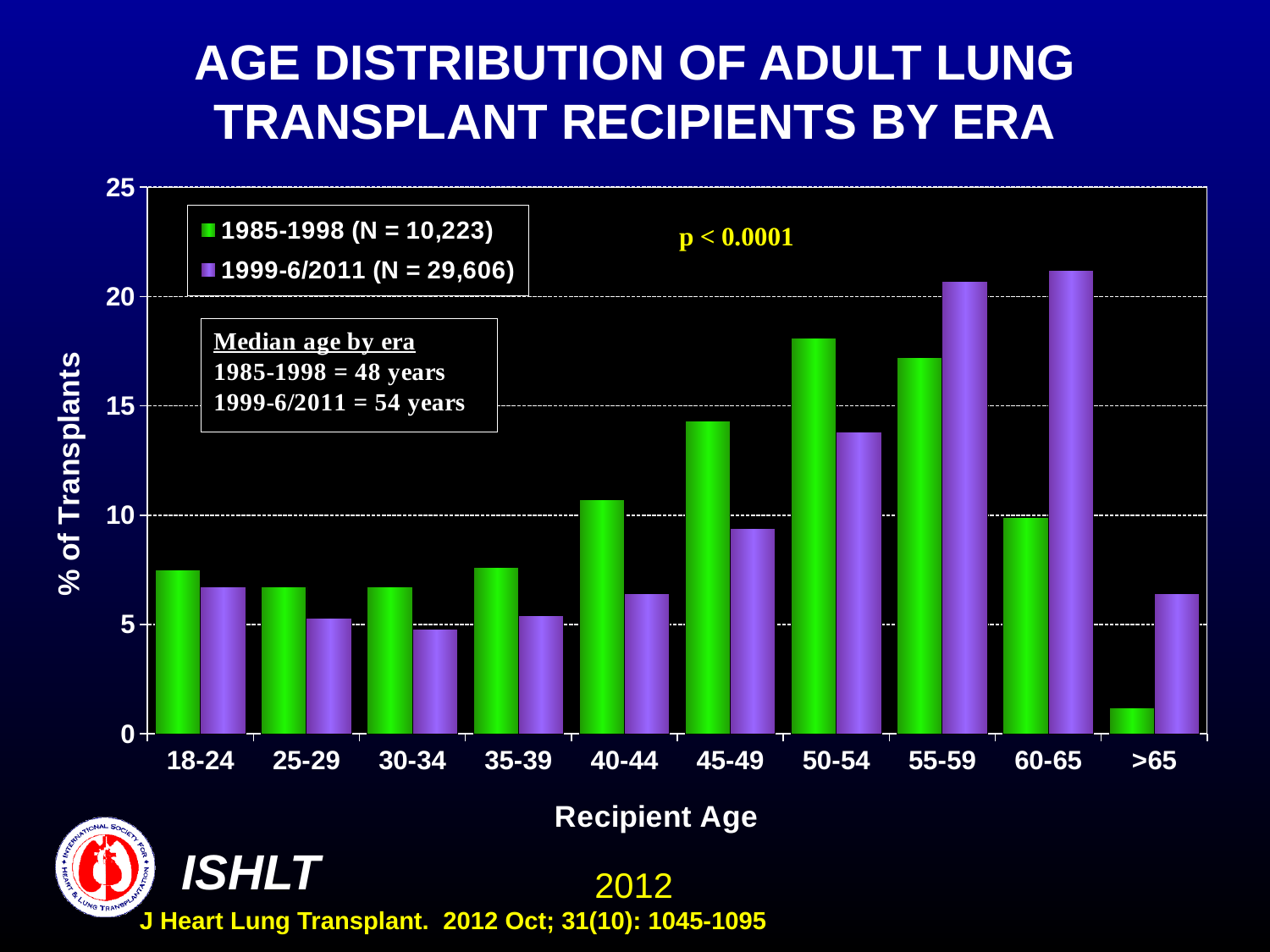
In the 50-54 age group, which series has the larger value, 1985-1998 or 1999-6/2011? 1985-1998 Is the value for the 1985-1998 series in the >65 age group greater or less than 5? less How many series does the legend list? 2 How many recipient age groups are shown on the x axis? 10 Which recipient age group has the highest value for the 1985-1998 series? 50-54 Is the value for the 1985-1998 series in the 50-54 age group greater or less than 15? greater Is the value for the 1999-6/2011 series in the 40-44 age group greater or less than 10? less What kind of chart is shown on the slide? bar chart Which recipient age group has the lowest value for the 1985-1998 series? >65 According to the legend, what is N for the 1999-6/2011 series? 29,606 In the 60-65 age group, which series has the larger value, 1985-1998 or 1999-6/2011? 1999-6/2011